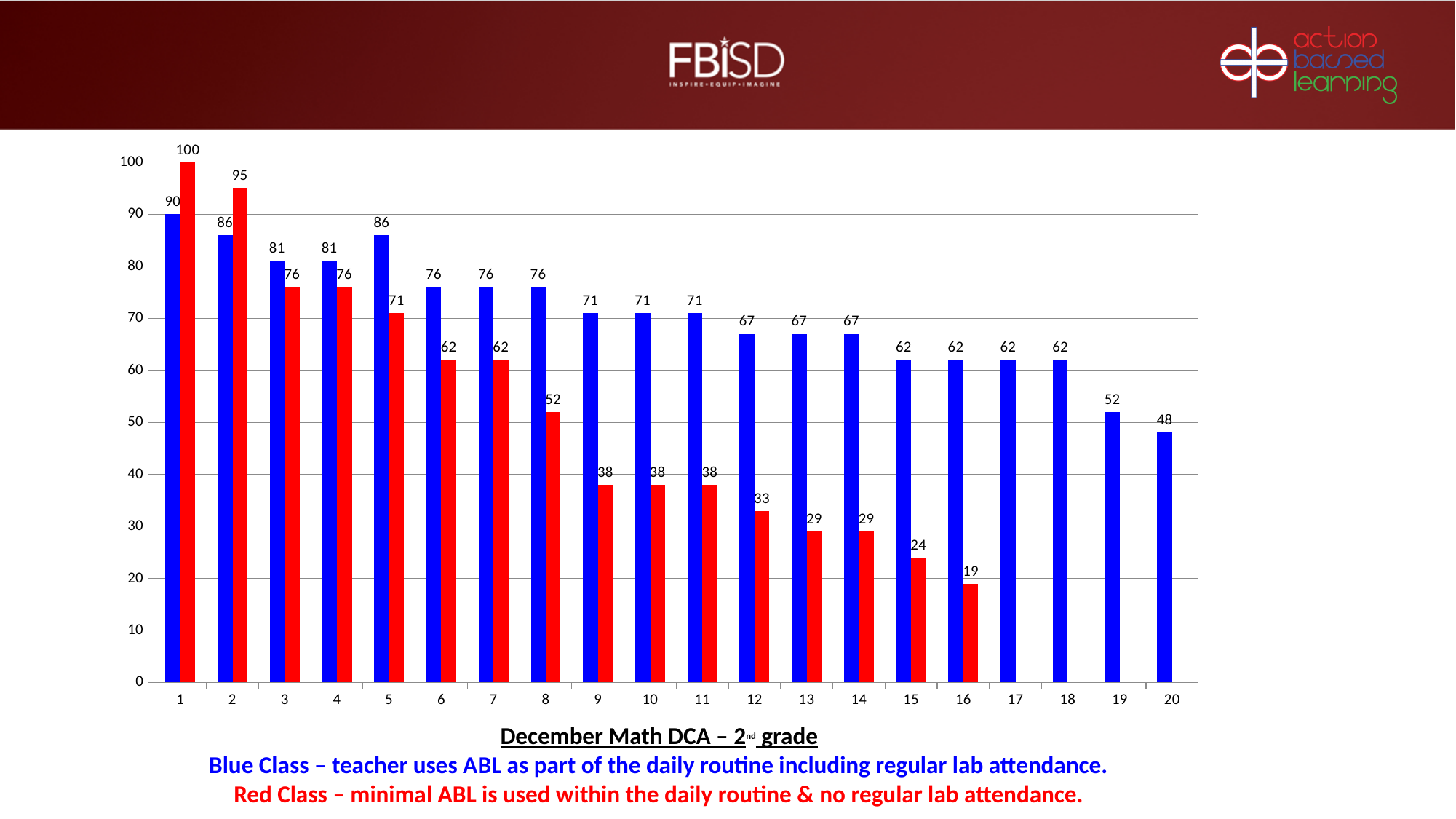
What is the red bar value for category 2? 95 What is the blue bar value for category 20? 48 Do the blue bar values rise or fall from category 1 to category 20? fall How many categories are shown on the x axis? 20 What kind of chart is shown on the slide? bar chart What is the blue bar value for category 1? 90 Which category has the highest red bar? 1 What is the difference between the blue and red bars for category 9? 33 For category 2, which is larger, the blue bar or the red bar? the red bar Which category has the lowest blue bar? 20 What is the red bar value for category 16? 19 How many categories have a red bar? 16